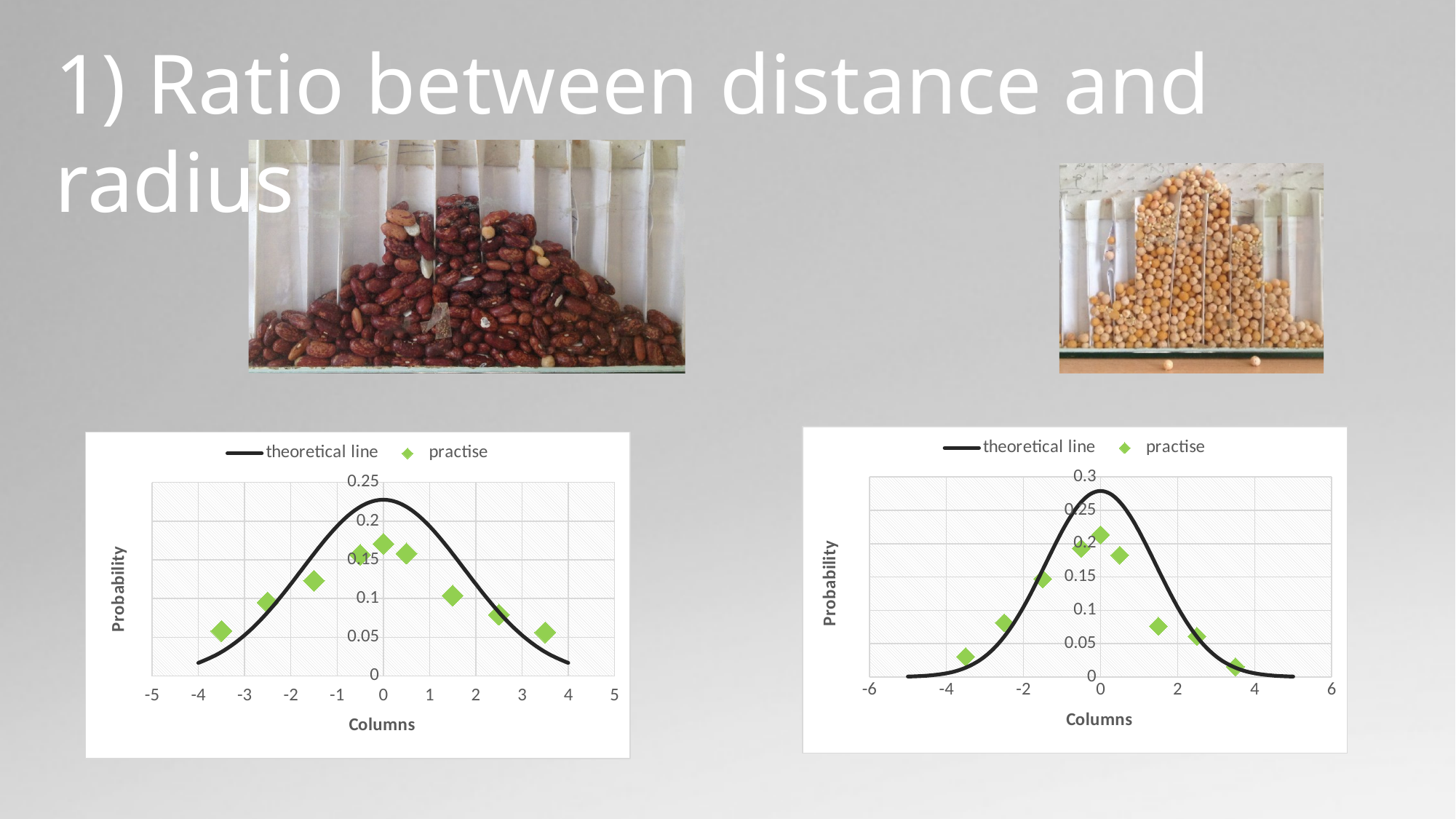
What is the y-axis title of the left chart? Probability In the right chart, at which column value is the lowest practise point? 3.5 In the right chart, is the practise value at column 0 greater or less than 0.15? greater How many practise points are plotted in the left chart? 9 In the left chart, at which column value is the highest practise point? 0 In the left chart, is the practise value at column -3.5 greater or less than 0.1? less In the left chart, is the practise value at column 0 greater or less than 0.15? greater In the right chart, which practise point is larger: the one at column -2.5 or the one at column 0? column 0 In the right chart, at which column value is the highest practise point? 0 What are the two legend entries on the right chart? theoretical line, practise How many series does the legend of the left chart list? 2